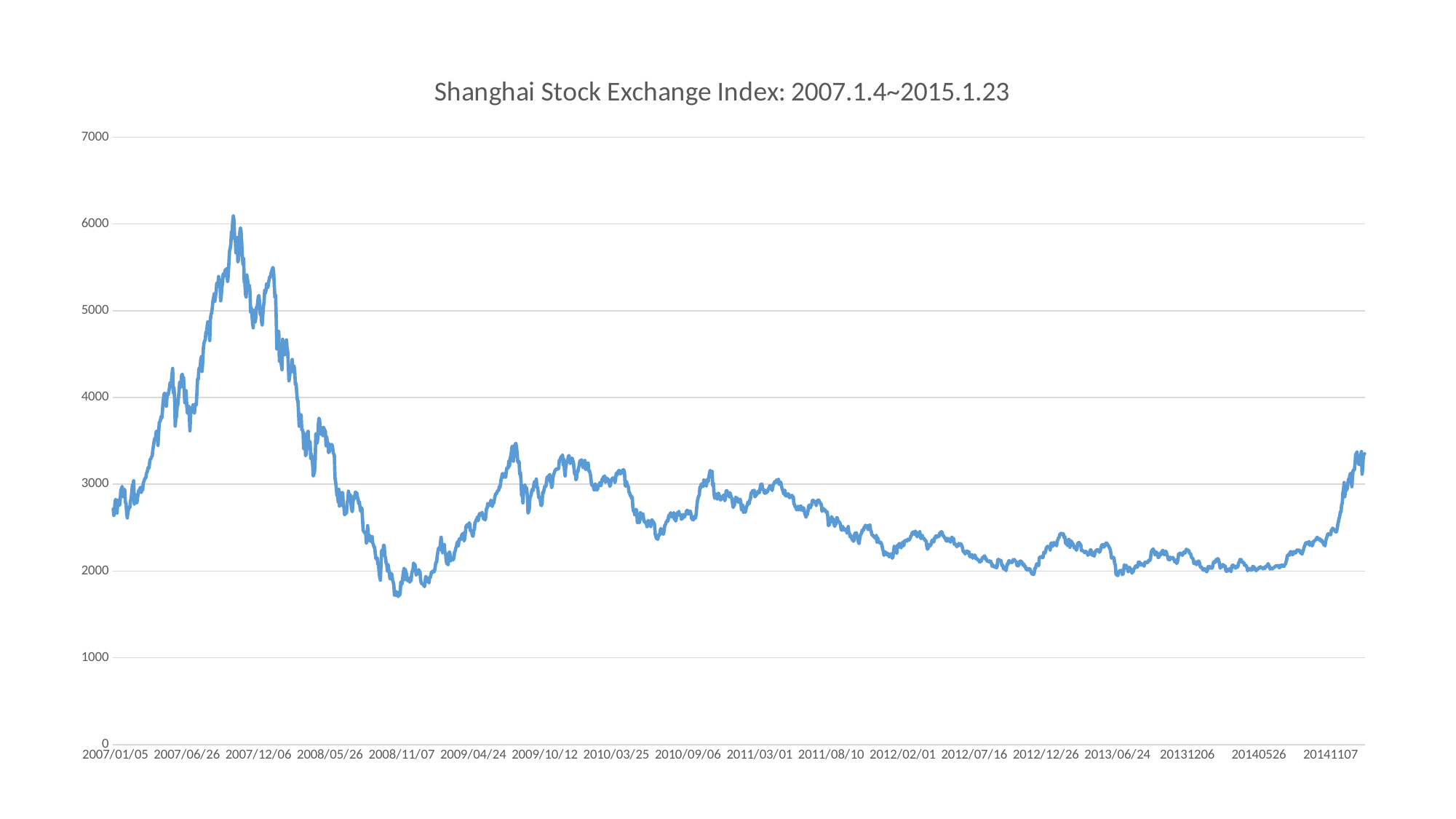
Is the value of the index at 2008/11/07 greater or less than 2000? less Is the peak value of the index in late 2007 greater or less than 6000? greater How many date labels are shown along the x axis? 18 Is the value of the index at 2007/01/05 greater or less than 2000? greater What is the highest value shown on the vertical axis? 7000 What kind of chart is shown on the slide? line chart Does the index rise or fall between 2007/01/05 and 2007/12/06? rise Between which two x-axis labels does the index reach its highest point? 2007/06/26 and 2007/12/06 What is the title of the chart? Shanghai Stock Exchange Index: 2007.1.4~2015.1.23 Does the index rise or fall between 2007/12/06 and 2008/11/07? fall